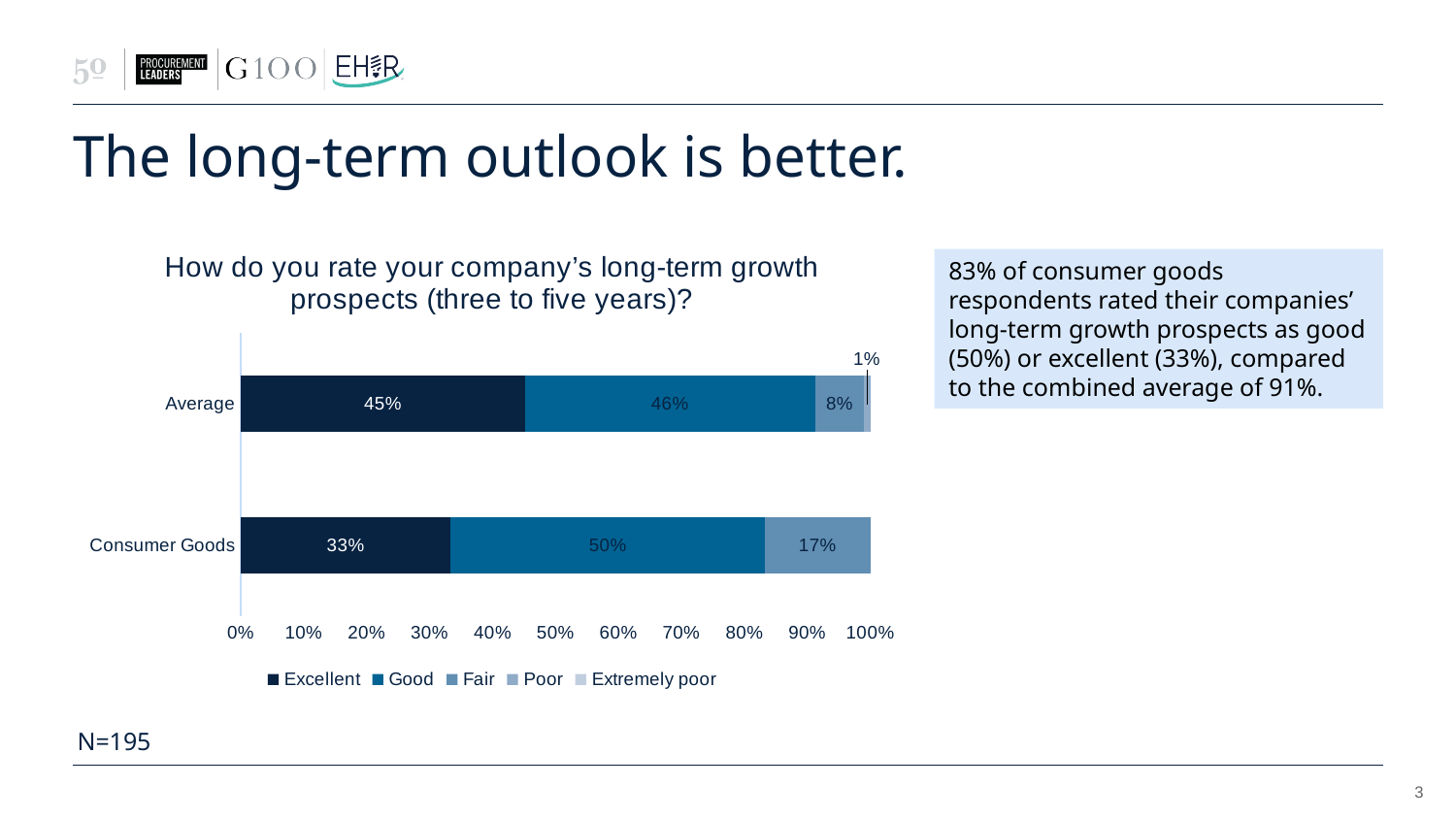
What is the difference between the Fair value for Consumer Goods and the Fair value for Average? 9% What is the title of the chart? How do you rate your company's long-term growth prospects (three to five years)? How many series does the legend list? 5 What is the Excellent value for the Average bar? 45% What is the Good value for the Average bar? 46% What is the Poor value shown for the Average bar? 1% Which category has the higher Excellent value, Average or Consumer Goods? Average What percentage of Consumer Goods respondents rated their long-term growth prospects as Excellent? 33% What kind of chart is shown on the slide? Stacked bar chart What is the combined Excellent and Good share for Consumer Goods? 83% How many categories are plotted on the chart? 2 What is the Fair value for Consumer Goods? 17%